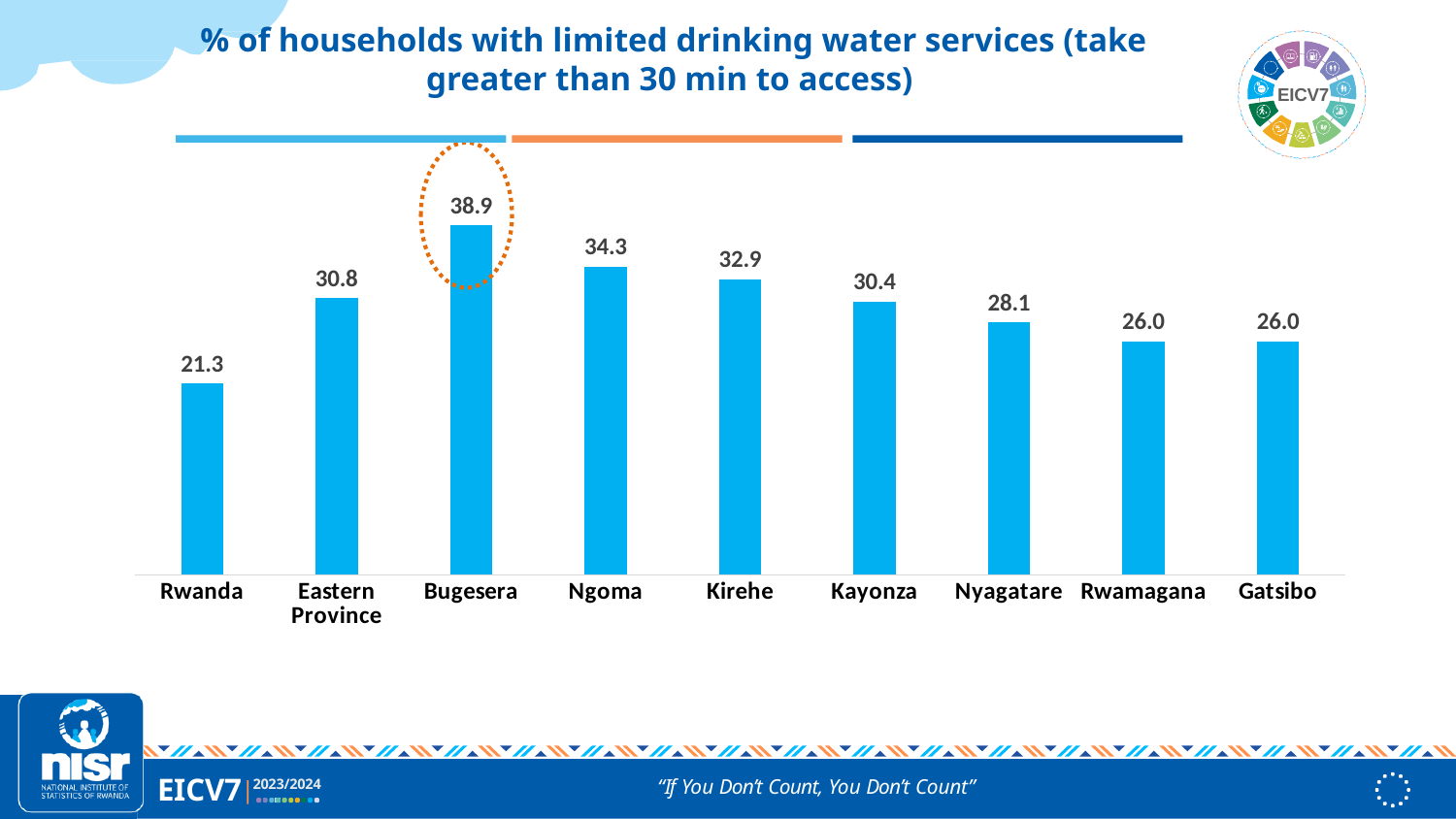
Which category has the highest value? Bugesera What is the value for Rwanda? 21.3 What is the value for Bugesera? 38.9 Which category has the lowest value? Rwanda What is the difference between the values for Ngoma and Kirehe? 1.4 How many categories are shown on the x axis? 9 What is the value for Eastern Province? 30.8 What is the difference between the values for Bugesera and Rwanda? 17.6 Which category's bar is highlighted with a dotted orange circle? Bugesera What is the value for Nyagatare? 28.1 Which is larger, the value for Kayonza or the value for Nyagatare? Kayonza What kind of chart is this? Bar chart